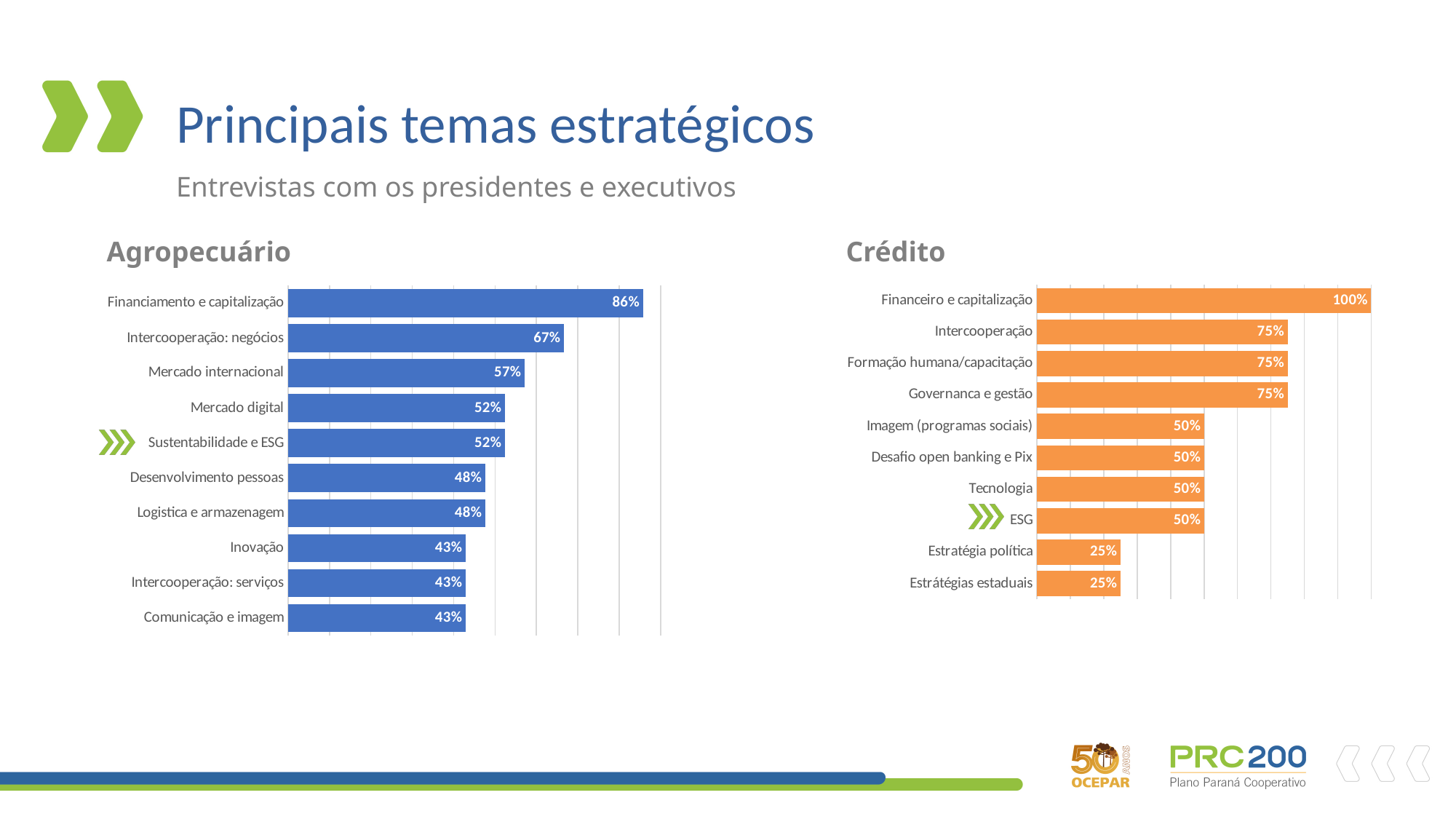
In the Crédito chart, which is larger: Tecnologia or Estratégias estaduais? Tecnologia How many categories does the Crédito chart show? 10 In the Agropecuário chart, what is the value for Sustentabilidade e ESG? 52% In the Agropecuário chart, what is the value for Mercado internacional? 57% In the Crédito chart, which category has the highest value? Financeiro e capitalização In the Crédito chart, what is the difference between Intercooperação and Estratégia política? 50% In the Agropecuário chart, which category has the highest value? Financiamento e capitalização What kind of chart is the Crédito chart? Bar chart In the Agropecuário chart, which is larger: Mercado digital or Inovação? Mercado digital In the Agropecuário chart, what is the difference between Financiamento e capitalização and Intercooperação: negócios? 19% How many categories does the Agropecuário chart show? 10 In the Crédito chart, what is the value for Governanca e gestão? 75%